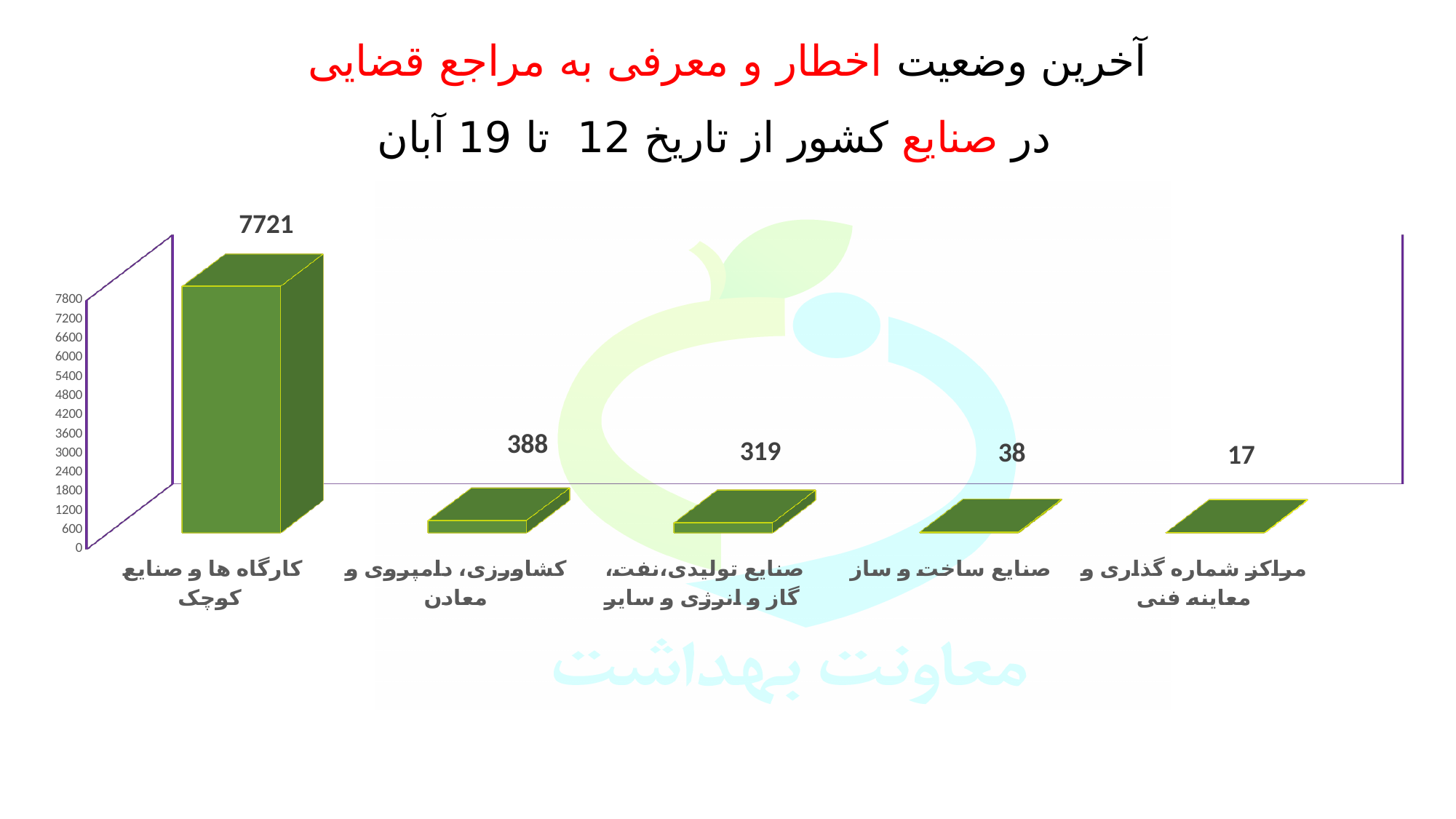
What is the highest tick value shown on the vertical axis? 7800 Which category has the highest value? کارگاه ها و صنایع کوچک Which is larger, the value for صنایع ساخت و ساز or the value for مراکز شماره گذاری و معاینه فنی? صنایع ساخت و ساز What is the value for کارگاه ها و صنایع کوچک? 7721 What is the value for مراکز شماره گذاری و معاینه فنی? 17 How many categories are shown in the chart? 5 What is the value for صنایع تولیدی، نفت، گاز و انرژی و سایر? 319 What is the value for کشاورزی، دامپروری و معادن? 388 What kind of chart is shown on the slide? bar chart What is the difference between the values for کشاورزی، دامپروری و معادن and صنایع تولیدی، نفت، گاز و انرژی و سایر? 69 What is the value for صنایع ساخت و ساز? 38 Which category has the lowest value? مراکز شماره گذاری و معاینه فنی